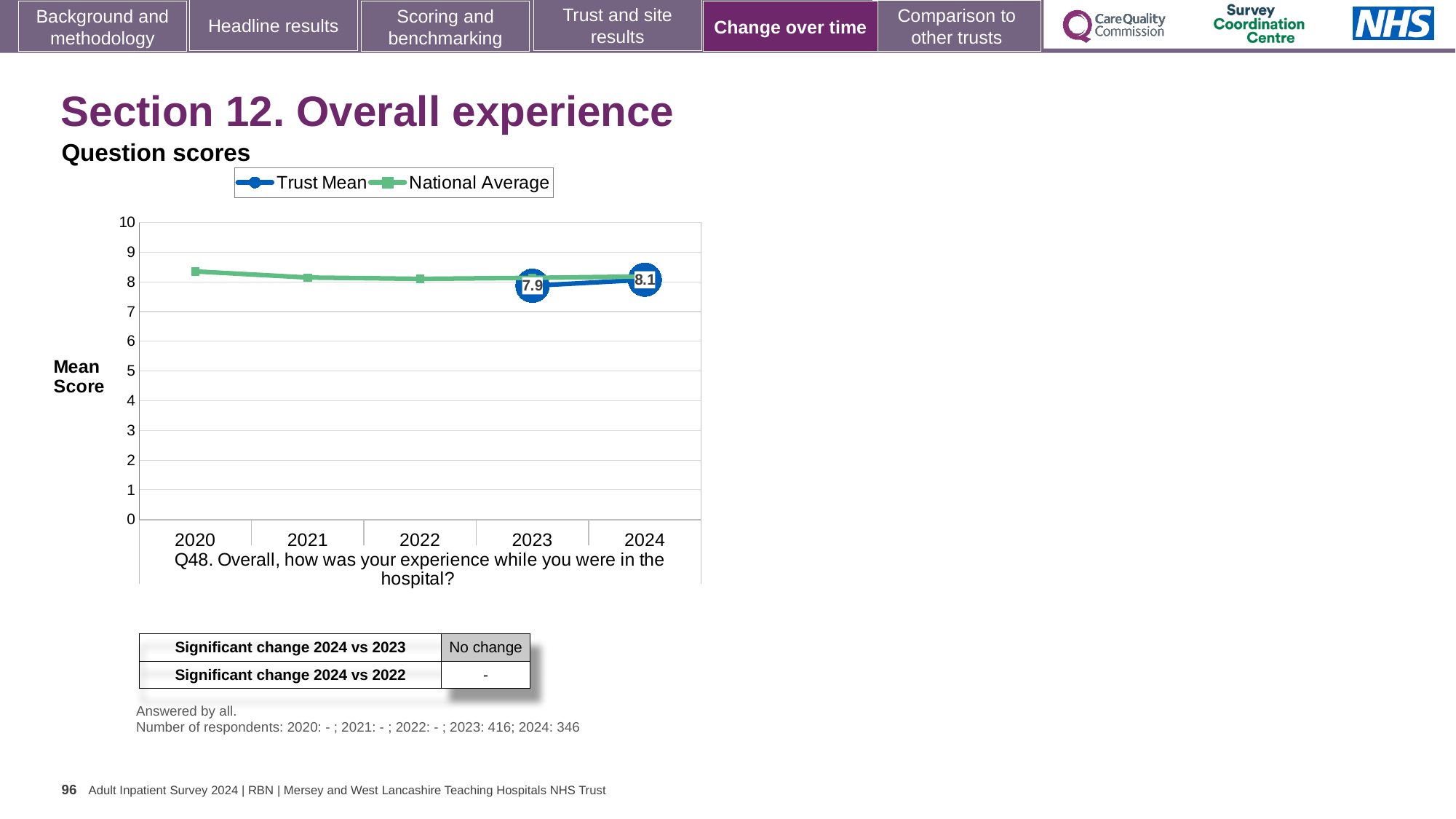
Is the National Average value for 2020 greater or less than 7? greater Which question is the chart about, as shown below the x axis? Q48. Overall, how was your experience while you were in the hospital? How many series does the chart legend list? 2 Which year has the higher Trust Mean, 2023 or 2024? 2024 Does the Trust Mean rise or fall from 2023 to 2024? rise What is the Trust Mean value for 2023? 7.9 How many years are shown on the x axis of the chart? 5 Is the National Average value for 2022 greater or less than 5? greater What is the label of the y axis of the chart? Mean Score What is the Trust Mean value for 2024? 8.1 What is the difference between the Trust Mean in 2024 and in 2023? 0.2 What kind of chart is shown on the slide? line chart